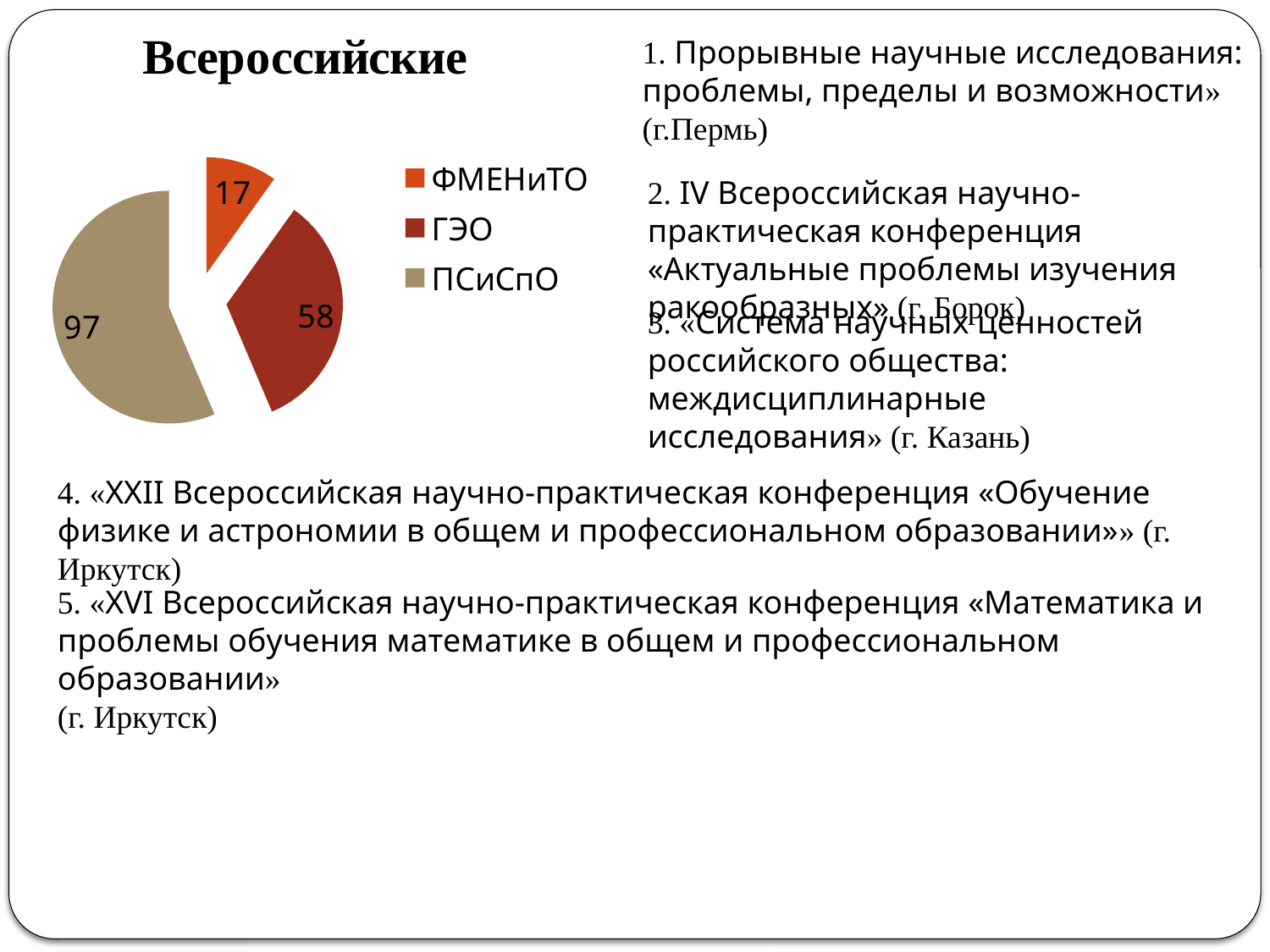
Which category has the smallest slice in the pie chart? ФМЕНиТО What is the title above the chart on the slide? Всероссийские What is the value for ПСиСпО in the pie chart? 97 What is the difference between the values for ПСиСпО and ГЭО? 39 How many slices does the pie chart have? 3 What kind of chart is shown on the slide? Pie chart What is the value for ФМЕНиТО in the pie chart? 17 Which category has the largest slice in the pie chart? ПСиСпО What is the value for ГЭО in the pie chart? 58 Which is larger, the value for ГЭО or the value for ФМЕНиТО? ГЭО What is the total of all slices in the pie chart? 172 What is the difference between the values for ГЭО and ФМЕНиТО? 41